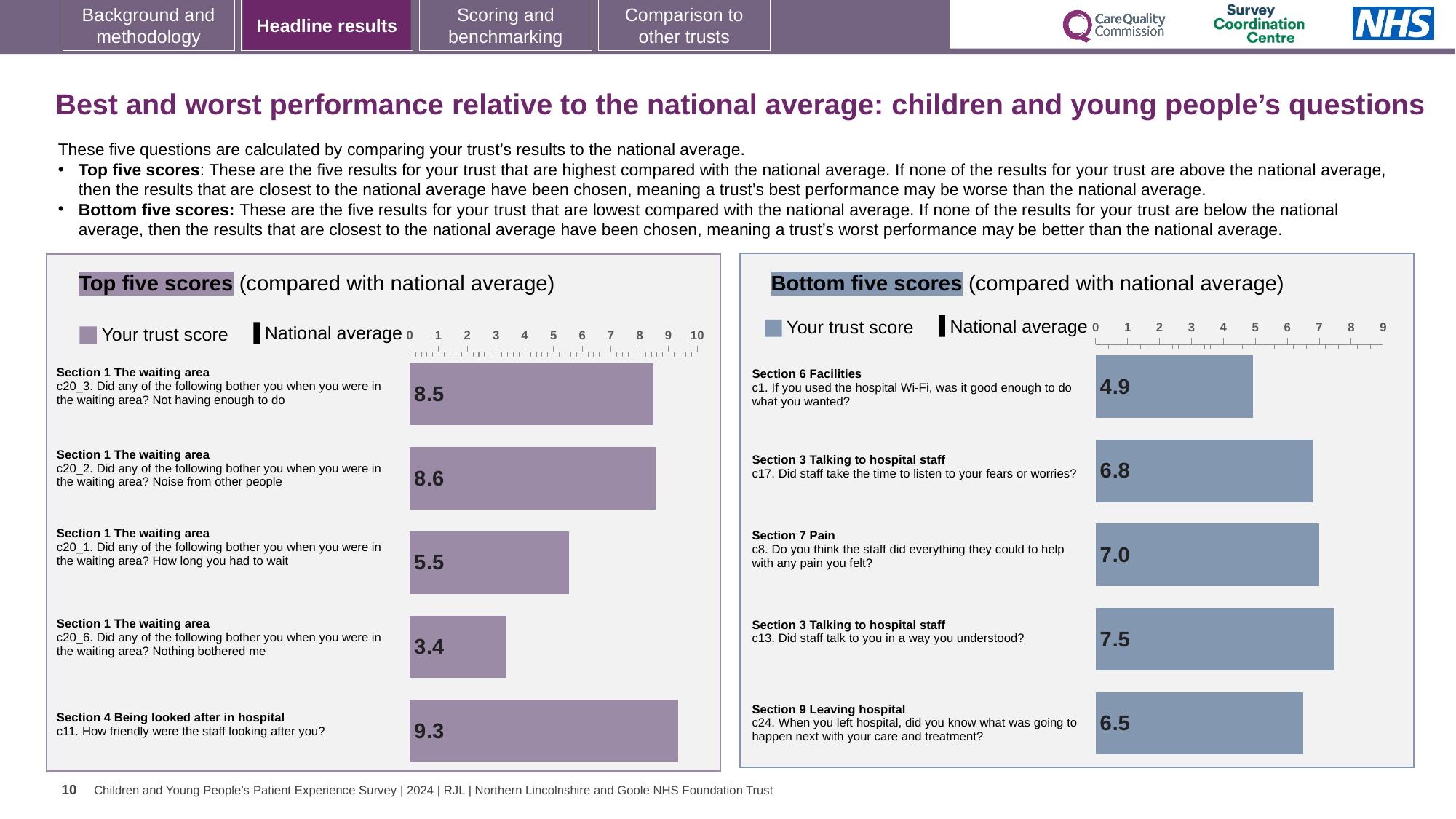
In the Top five scores chart, which question has the highest trust score? c11. How friendly were the staff looking after you? In the Bottom five scores chart, what is the trust score for c13. Did staff talk to you in a way you understood? 7.5 In the Bottom five scores chart, which question has the lowest trust score? c1. If you used the hospital Wi-Fi, was it good enough to do what you wanted? In the Top five scores chart, what is the trust score for c11. How friendly were the staff looking after you? 9.3 In the Top five scores chart, which question has the lowest trust score? c20_6. Did any of the following bother you when you were in the waiting area? Nothing bothered me In the Bottom five scores chart, what is the trust score for c1. If you used the hospital Wi-Fi, was it good enough to do what you wanted? 4.9 In the Top five scores chart, what is the trust score for c20_1. Did any of the following bother you when you were in the waiting area? How long you had to wait? 5.5 In the Top five scores chart, what is the difference between the trust scores for c11 and c20_6? 5.9 How many questions are plotted in the Bottom five scores chart? 5 In the Bottom five scores chart, what is the difference between the trust scores for c13 (7.5) and c1 (4.9)? 2.6 In the Top five scores chart, which has the larger trust score: c20_1 (How long you had to wait) or c20_6 (Nothing bothered me)? c20_1 (How long you had to wait) What type of chart is the Top five scores chart? Bar chart